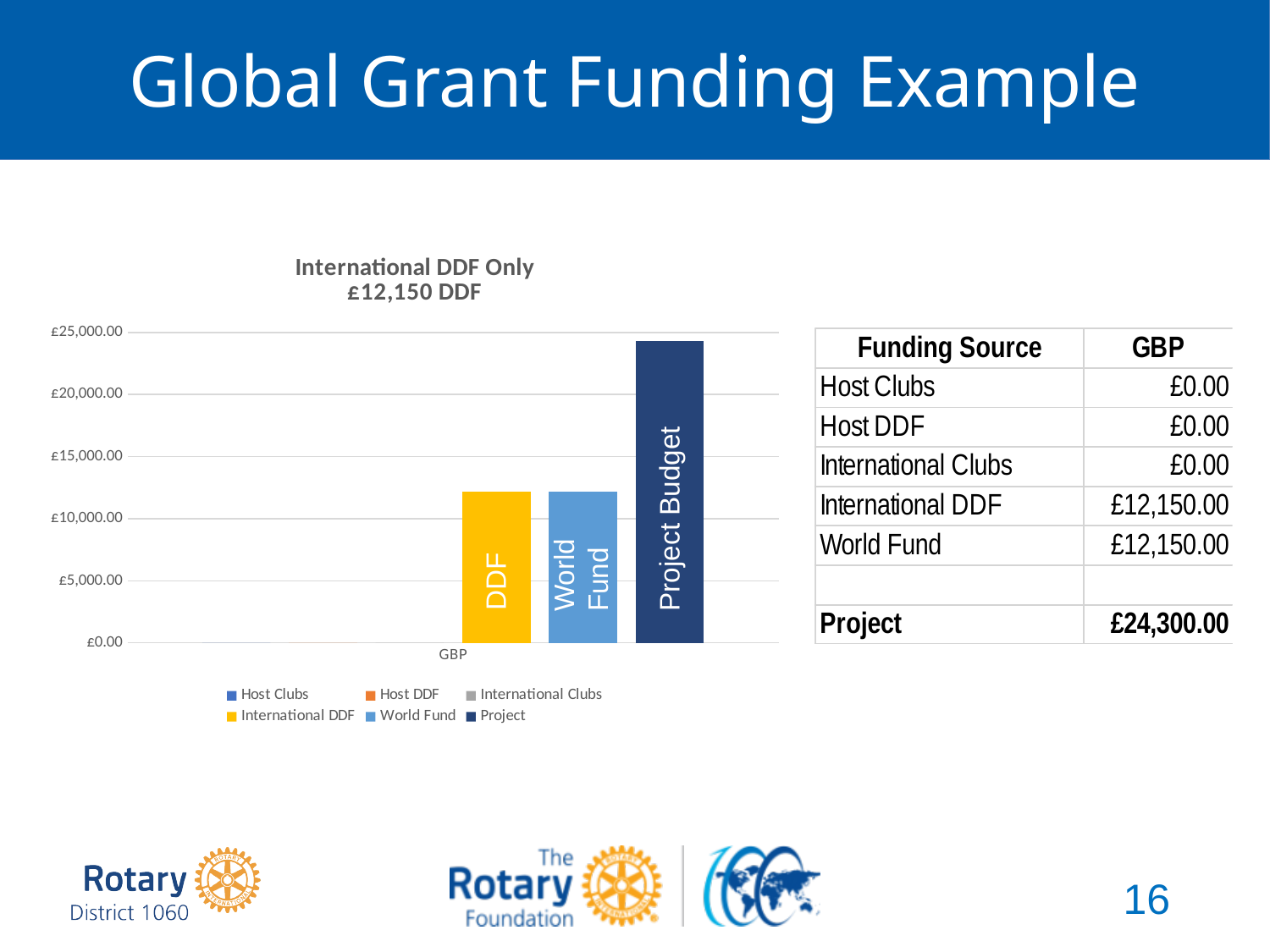
What is the value of the Project bar, as given in the table beside the chart? £24,300.00 What colour is the International DDF series in the chart legend? yellow How many series does the chart legend list? 6 Is the value of the DDF bar greater or less than £10,000.00? greater What kind of chart is shown on the slide? bar chart Which bar in the chart is the tallest? Project Budget Is the value of the Project Budget bar greater or less than £20,000.00? greater Is the value of the World Fund bar greater or less than £15,000.00? less What is the title of the chart? International DDF Only £12,150 DDF What value does the chart title give for International DDF? £12,150 DDF Which is larger, the Project Budget bar or the World Fund bar? Project Budget How many categories are shown on the x axis of the chart? 1